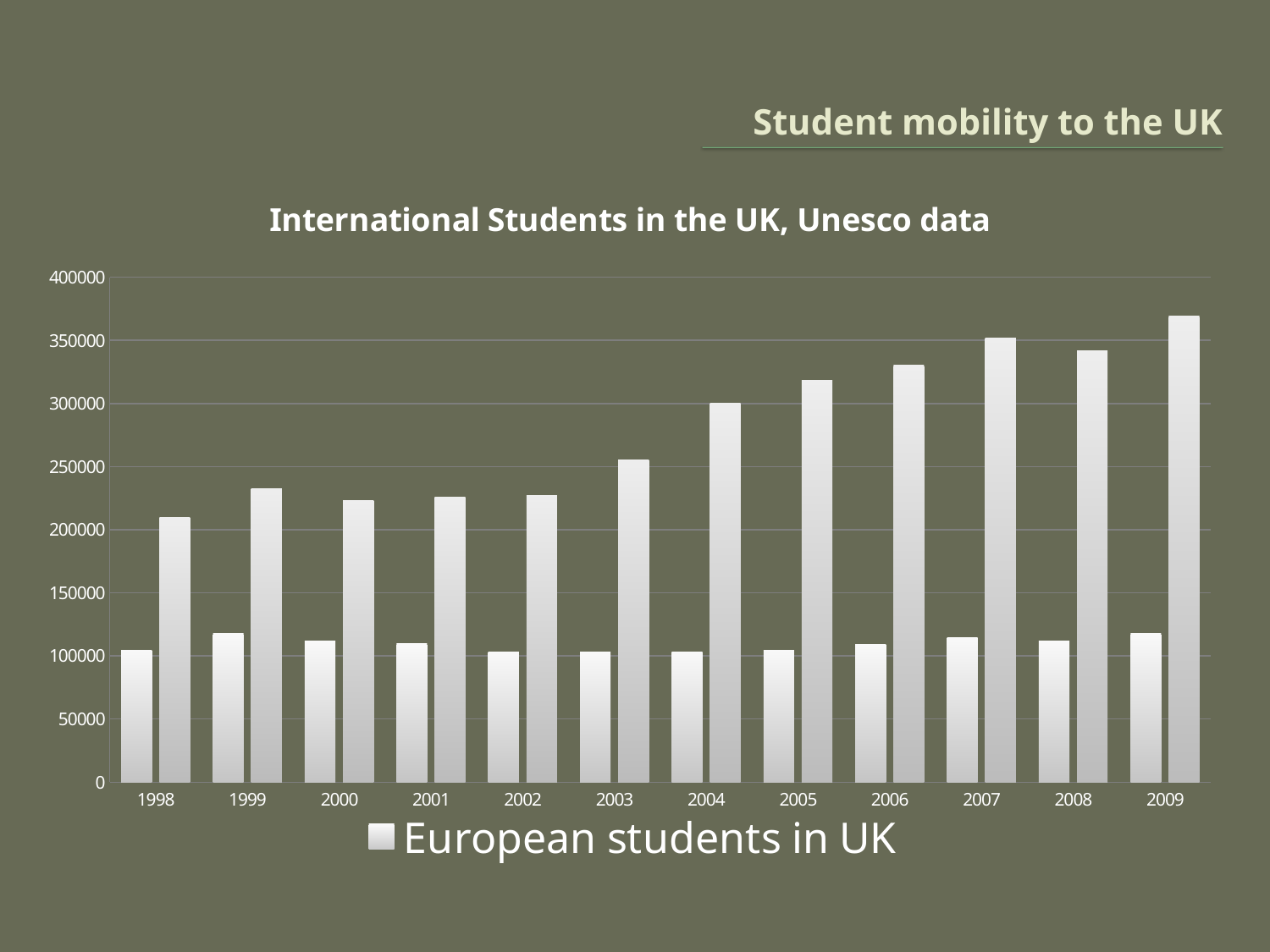
Is the taller bar for 2005 greater or less than 300000? greater Is the shorter bar for 1999 greater or less than 150000? less What is the title of the chart? International Students in the UK, Unesco data Which year has the larger taller bar, 2007 or 2008? 2007 What kind of chart is shown on the slide? bar chart Is the taller bar for 1998 greater or less than 250000? less How many years are shown on the x axis? 12 Which year has the lowest value among the taller bars? 1998 What is the series name shown in the legend? European students in UK How many series does the chart legend list? 1 Which year has the highest value among the taller bars? 2009